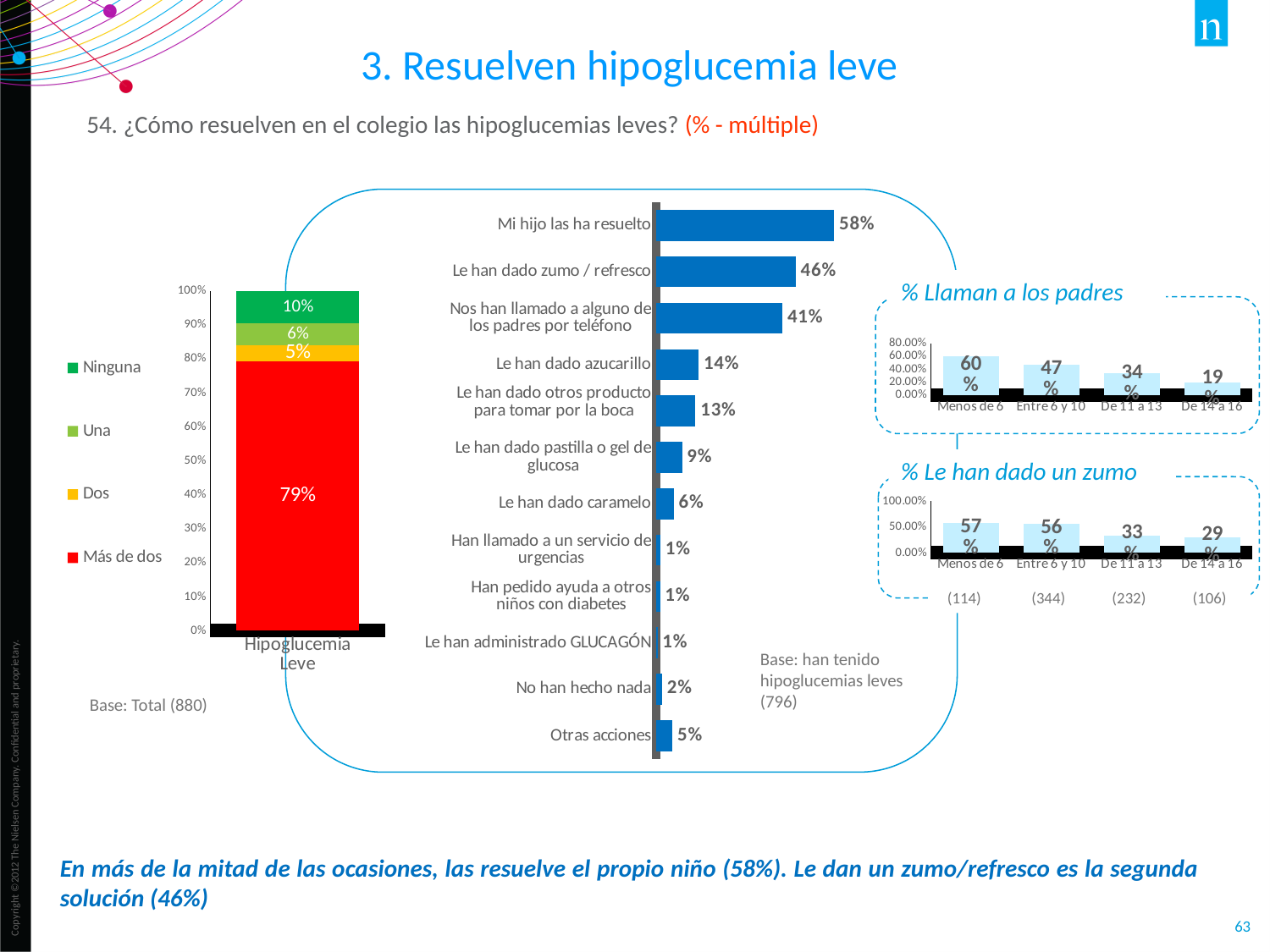
What kind of chart is the central chart with the category "Mi hijo las ha resuelto"? Bar chart In the central horizontal bar chart, what is the value for "Mi hijo las ha resuelto"? 58% In the central horizontal bar chart, which is larger: "Le han dado azucarillo" or "Le han dado caramelo"? Le han dado azucarillo In the central horizontal bar chart, what is the difference between "Le han dado zumo / refresco" and "Nos han llamado a alguno de los padres por teléfono"? 5% In the stacked bar chart on the left ("Hipoglucemia Leve"), what is the value for "Más de dos"? 79% In the "% Llaman a los padres" chart, what is the value for "De 14 a 16"? 19% In the "% Le han dado un zumo" chart, which category has the lowest value? De 14 a 16 In the central horizontal bar chart, which category has the highest value? Mi hijo las ha resuelto How many categories are plotted in the central horizontal bar chart? 12 In the stacked bar chart on the left, what is the total of the "Ninguna", "Una" and "Dos" segments? 21% In the "% Le han dado un zumo" chart, do the values rise or fall from "Menos de 6" to "De 14 a 16"? Fall How many series does the legend of the stacked bar chart on the left list? 4